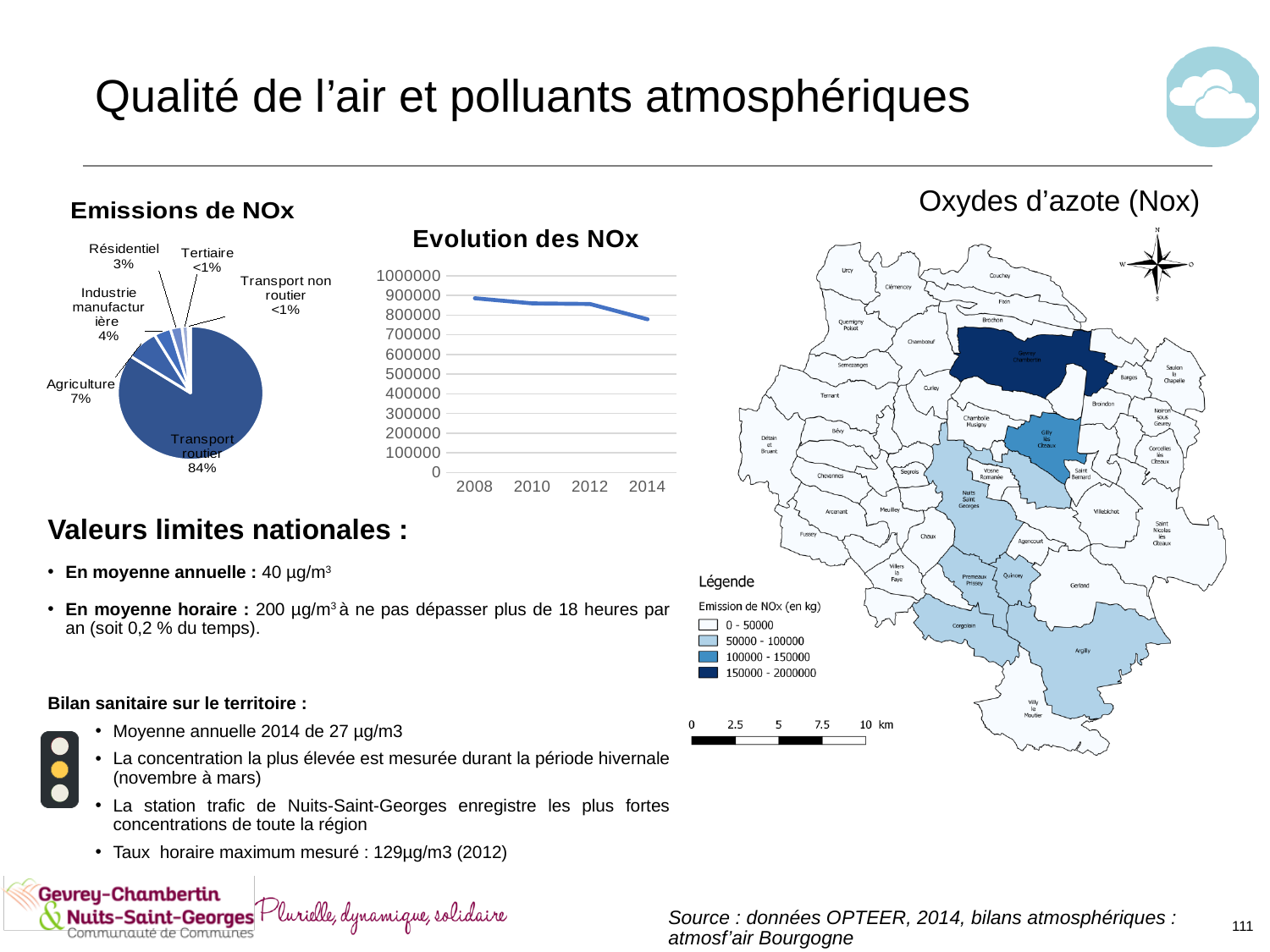
In the pie chart 'Emissions de NOx', what share of emissions comes from Agriculture? 7% In the pie chart 'Emissions de NOx', what share of emissions comes from Transport routier? 84% In the chart 'Evolution des NOx', do the values rise or fall from 2008 to 2014? Fall What kind of chart is 'Evolution des NOx'? Line chart In the pie chart 'Emissions de NOx', what share of emissions comes from Industrie manufacturière? 4% In the pie chart 'Emissions de NOx', what is the difference in percentage points between Transport routier and Agriculture? 77 In the chart 'Evolution des NOx', is the value for 2008 greater or less than 800000? greater In the pie chart 'Emissions de NOx', what share of emissions comes from Résidentiel? 3% In the pie chart 'Emissions de NOx', which category has the largest share? Transport routier In the pie chart 'Emissions de NOx', which is larger, Agriculture or Résidentiel? Agriculture How many categories are shown in the pie chart 'Emissions de NOx'? 6 How many years are plotted on the x axis of the chart 'Evolution des NOx'? 4